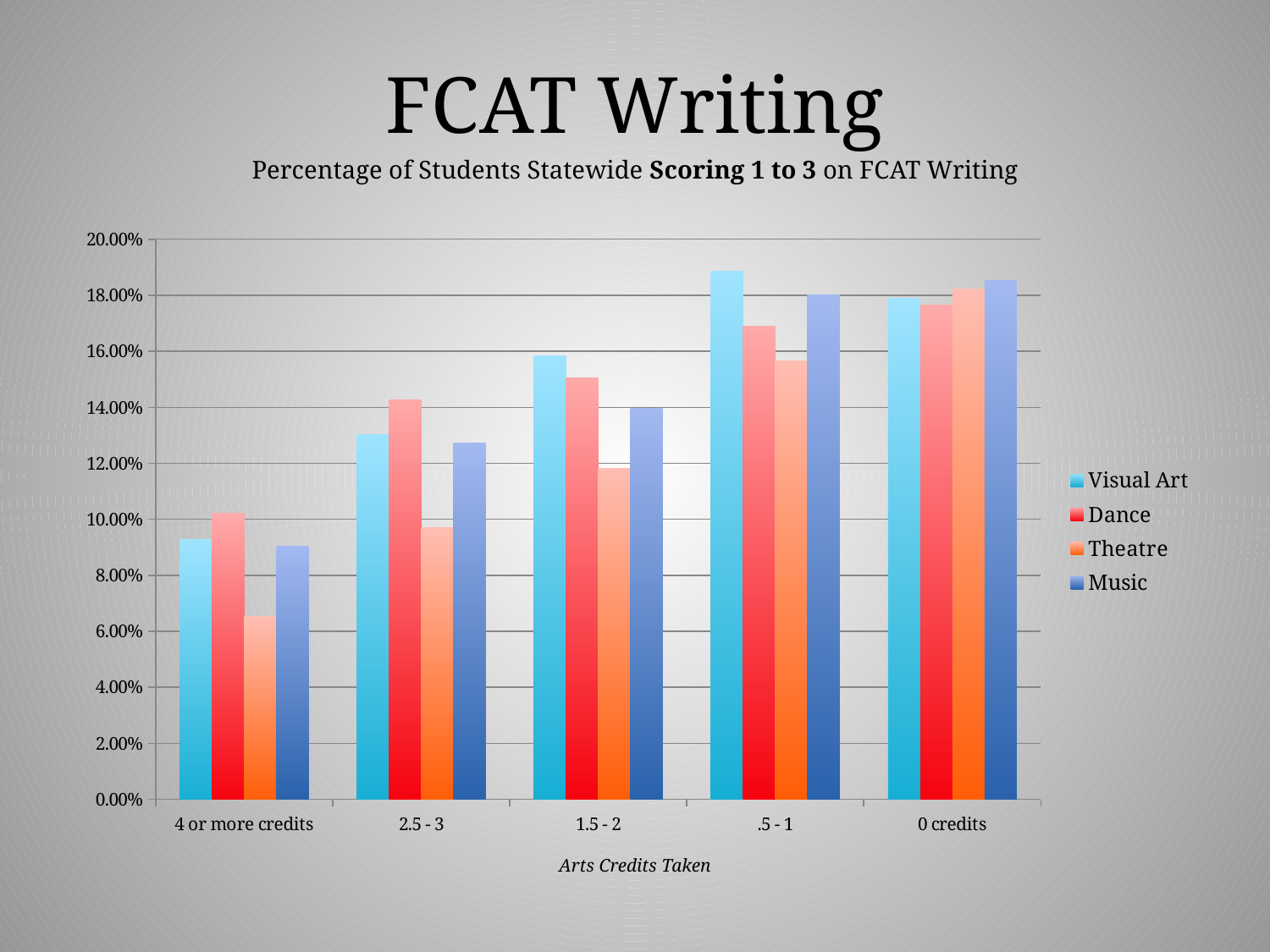
Within the .5 - 1 credits group, which series has the highest value? Visual Art Is the value for Dance at 2.5 - 3 credits greater or less than 12.00%? greater What is the title of the x axis? Arts Credits Taken Is the value for Theatre at 4 or more credits greater or less than 8.00%? less What kind of chart is shown on the slide? bar chart How many categories of arts credits are shown on the x axis? 5 Do the Theatre values generally rise or fall moving from 4 or more credits to 0 credits along the x axis? rise How many series does the legend list? 4 Is the value for Visual Art at .5 - 1 credits greater or less than 18.00%? greater For which arts credits category is the Visual Art value highest? .5 - 1 Within the 4 or more credits group, which series has the lowest value? Theatre At 1.5 - 2 credits, which is larger: Theatre or Music? Music